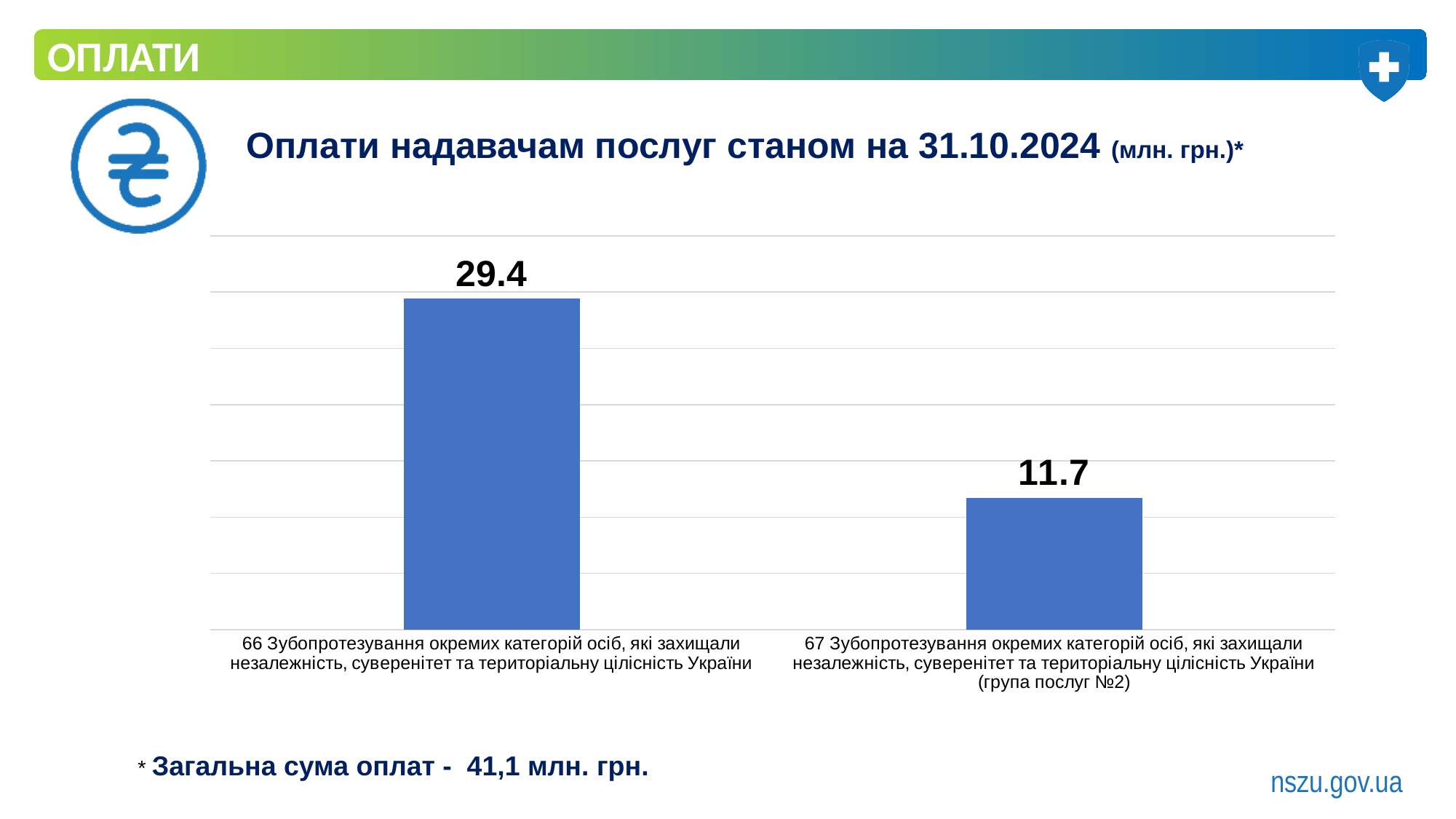
What is the value for category 67 (Зубопротезування окремих категорій осіб ... (група послуг №2))? 11.7 Which is larger: the value for category 66 or the value for category 67? Category 66 What total sum of payments is stated in the footnote below the chart? 41,1 млн. грн. What is the value for category 66 (Зубопротезування окремих категорій осіб, які захищали незалежність, суверенітет та територіальну цілісність України)? 29.4 What is the difference between the values for category 66 and category 67? 17.7 What kind of chart is shown on the slide? Bar chart How many categories are shown in the chart? 2 Which category has the lowest value? 67 Зубопротезування окремих категорій осіб, які захищали незалежність, суверенітет та територіальну цілісність України (група послуг №2) Do the values rise or fall from the left bar to the right bar? Fall Which category has the highest value? 66 Зубопротезування окремих категорій осіб, які захищали незалежність, суверенітет та територіальну цілісність України What is the title of the chart? Оплати надавачам послуг станом на 31.10.2024 (млн. грн.)*